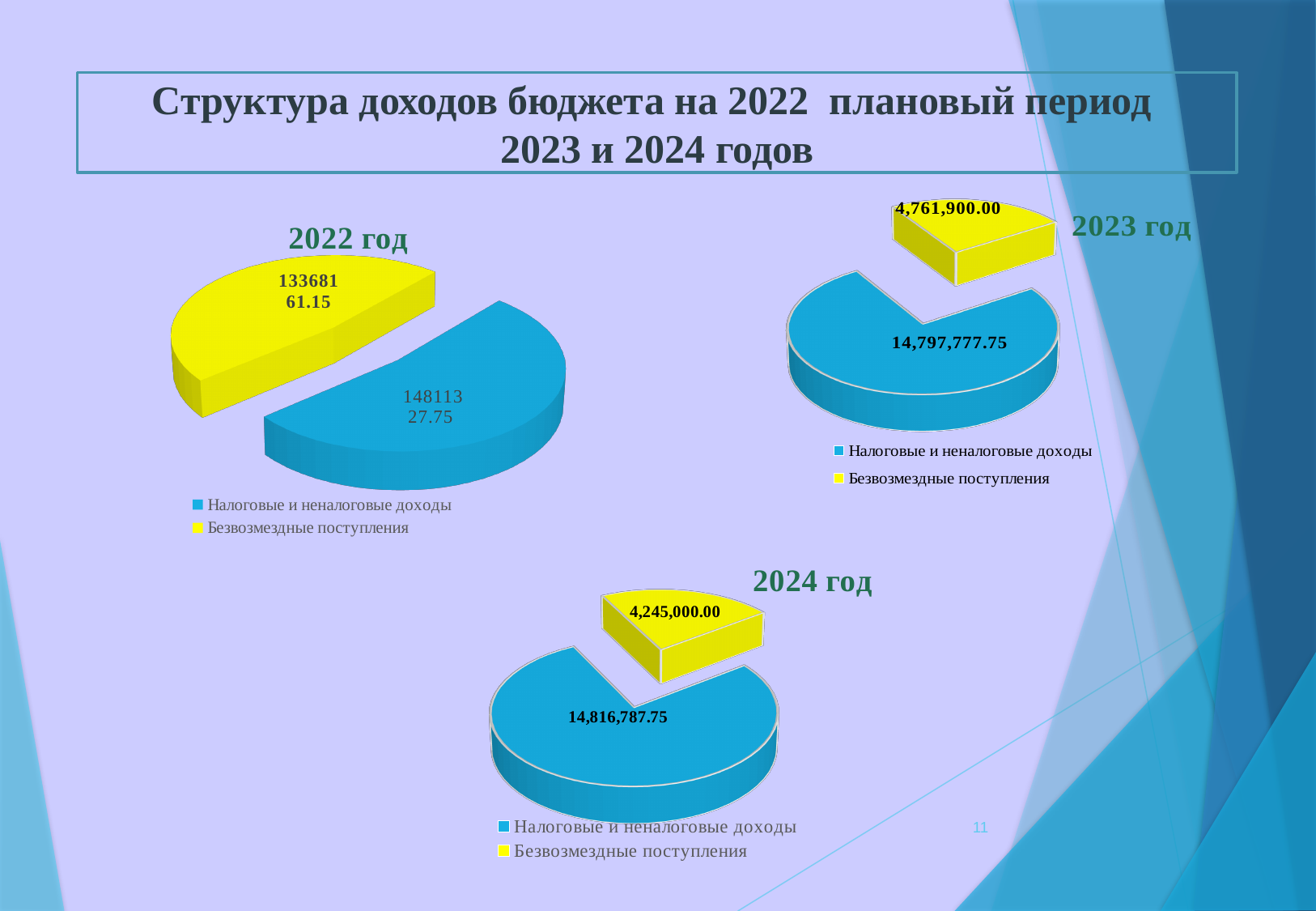
In the 2024 год chart, what is the value for Налоговые и неналоговые доходы? 14,816,787.75 What kind of chart is used for the 2023 год chart? Pie chart How many charts are shown on the slide? 3 In the 2024 год chart, what is the total of the two slices? 19,061,787.75 In the 2023 год chart, what is the value for Безвозмездные поступления? 4,761,900.00 How many series does the legend of the 2024 год chart list? 2 Which colour represents Безвозмездные поступления in the charts? Yellow In the 2023 год chart, what is the difference between Налоговые и неналоговые доходы and Безвозмездные поступления? 10,035,877.75 In the 2023 год chart, which category has the smallest slice? Безвозмездные поступления In the 2024 год chart, which category has the largest slice? Налоговые и неналоговые доходы In the 2023 год chart, what is the value for Налоговые и неналоговые доходы? 14,797,777.75 In the 2024 год chart, what is the value for Безвозмездные поступления? 4,245,000.00